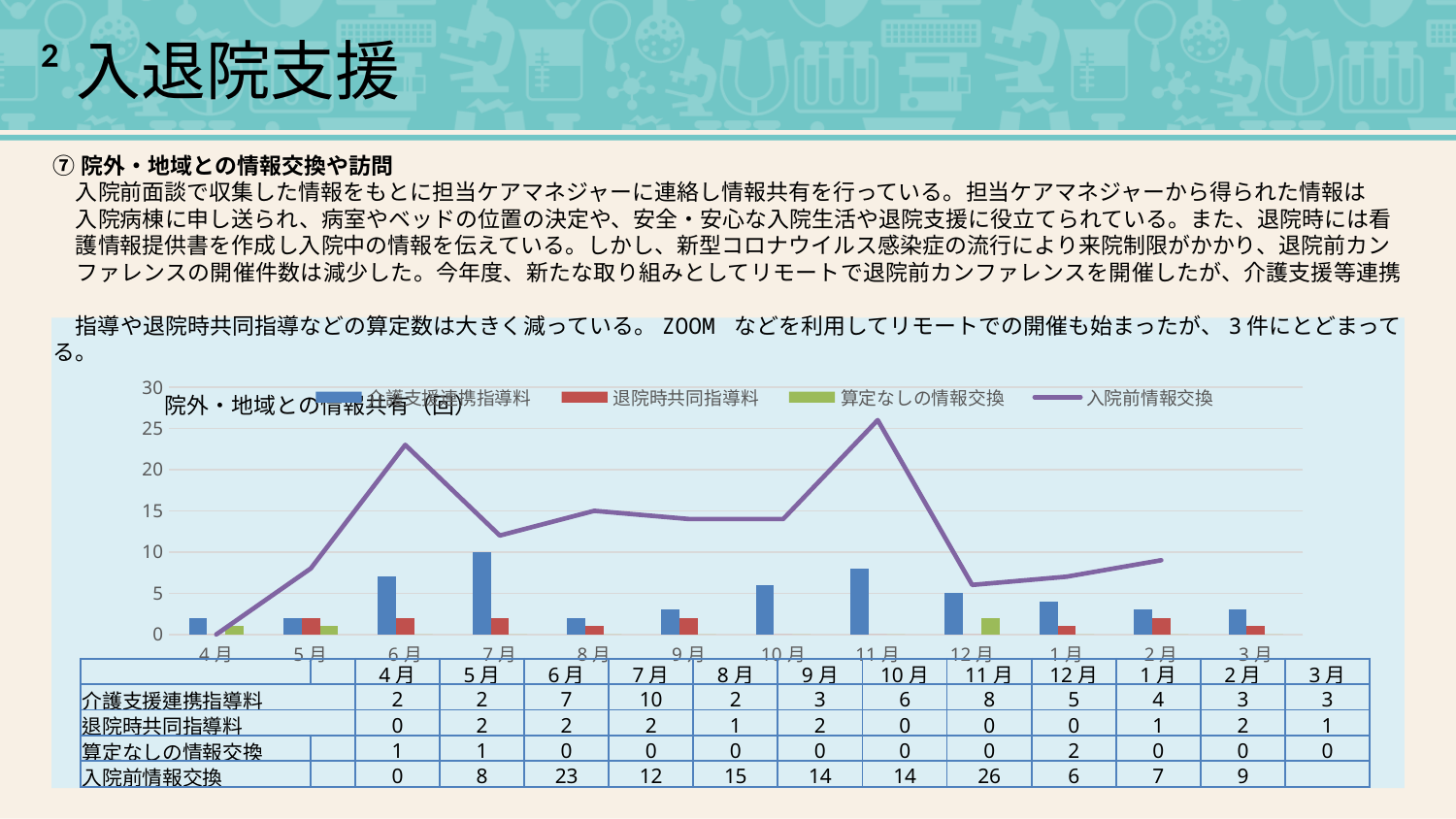
In which month is 入院前情報交換 highest? 11月 What is the value of 退院時共同指導料 for 5月? 2 Which is larger, 介護支援連携指導料 in 6月 or in 11月? 11月 How many series does the legend list? 4 What is the value of 介護支援連携指導料 for 7月? 10 Does 入院前情報交換 rise or fall from 11月 to 12月? fall How many months are shown on the x axis of the chart? 12 What is the title of the chart? 院外・地域との情報共有（回） What is the difference between 入院前情報交換 in 6月 and in 7月? 11 What kind of chart is used for 入院前情報交換? line chart What is the value of 入院前情報交換 for 11月? 26 In which month is 介護支援連携指導料 highest? 7月